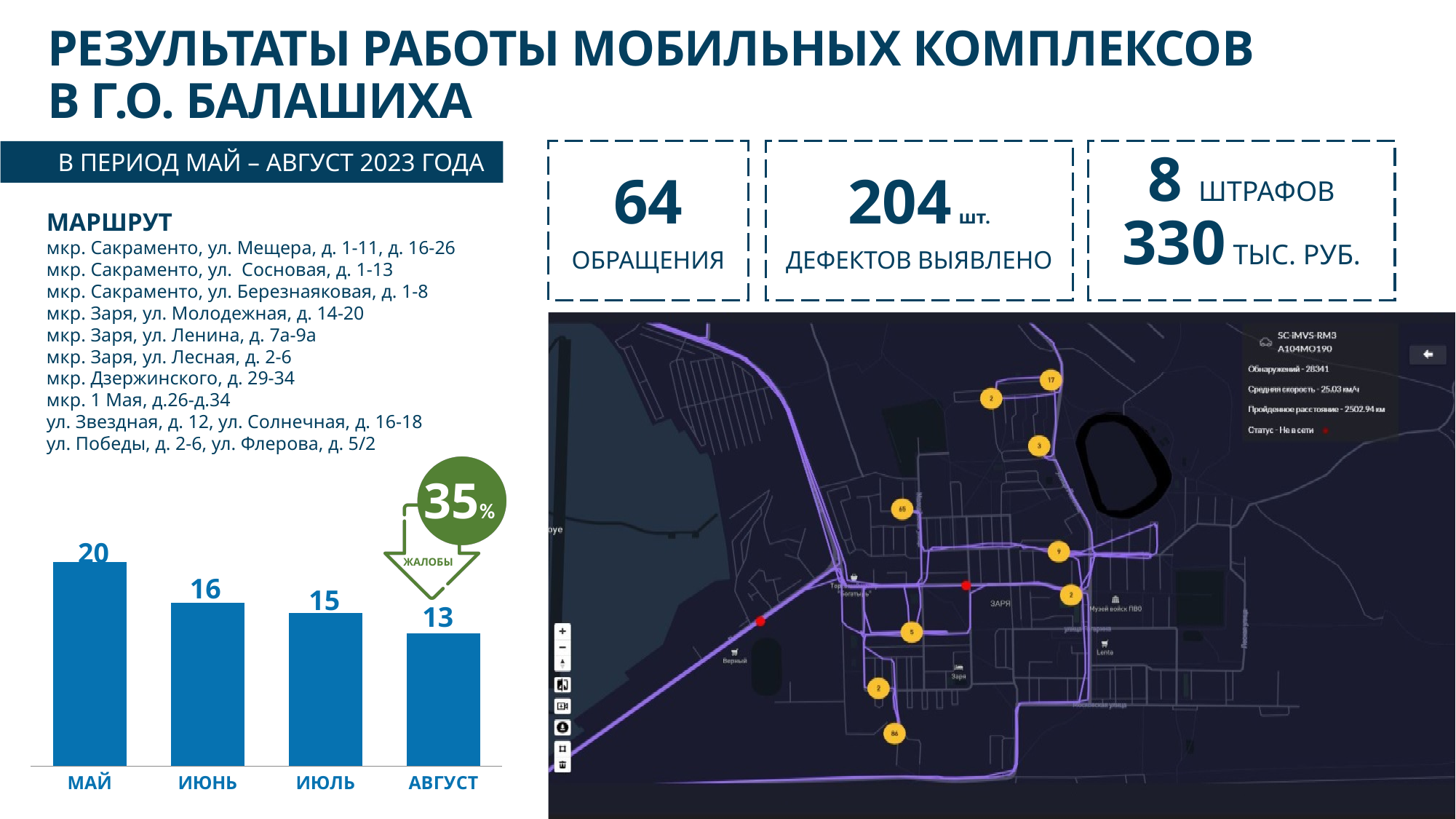
What is the value for ИЮНЬ in the bar chart? 16 What percentage decrease in ЖАЛОБЫ is shown in the green arrow next to the bar chart? 35% What is the difference between the values for МАЙ and АВГУСТ in the bar chart? 7 What is the value for АВГУСТ in the bar chart? 13 What is the value for ИЮЛЬ in the bar chart? 15 How many months are shown in the bar chart? 4 Which is larger in the bar chart, the value for ИЮНЬ or the value for ИЮЛЬ? ИЮНЬ Which month has the lowest value in the bar chart? АВГУСТ What is the value for МАЙ in the bar chart? 20 Do the values in the bar chart rise or fall from МАЙ to АВГУСТ? fall Which month has the highest value in the bar chart? МАЙ What kind of chart is shown on the slide? bar chart